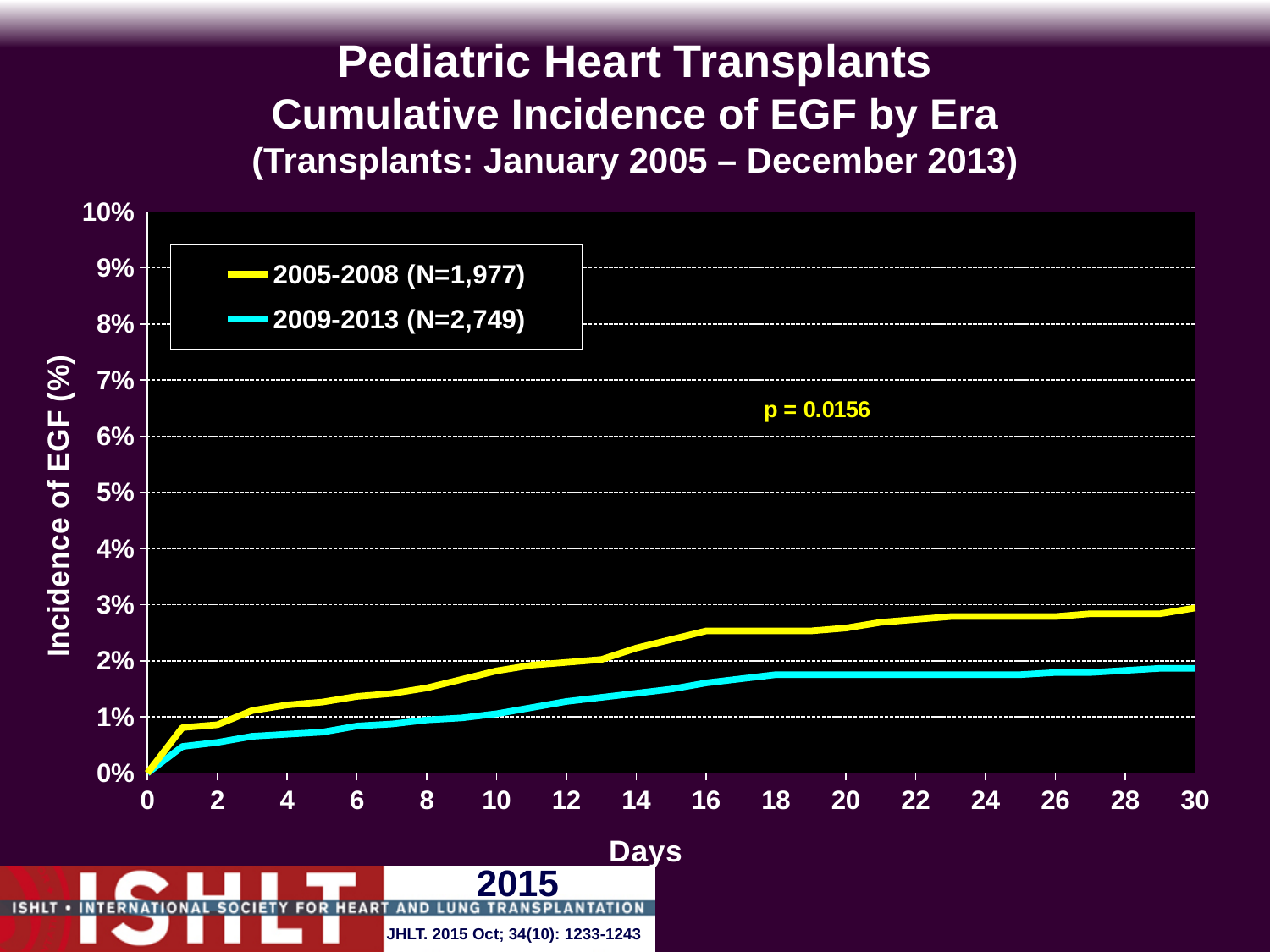
Do the cumulative incidence values rise or fall as days increase? rise How many series does the legend list? 2 Is the value for 2005-2008 at day 16 greater or less than 2%? greater Is the value for 2005-2008 at day 10 greater or less than 2%? less What p-value is shown on the chart? p = 0.0156 What is the N for the 2009-2013 era in the legend? 2,749 Which era has the lower cumulative incidence of EGF at day 16? 2009-2013 Is the value for 2009-2013 at day 30 greater or less than 2%? less What kind of chart is shown on the slide? line chart Which era has the higher cumulative incidence of EGF at day 30? 2005-2008